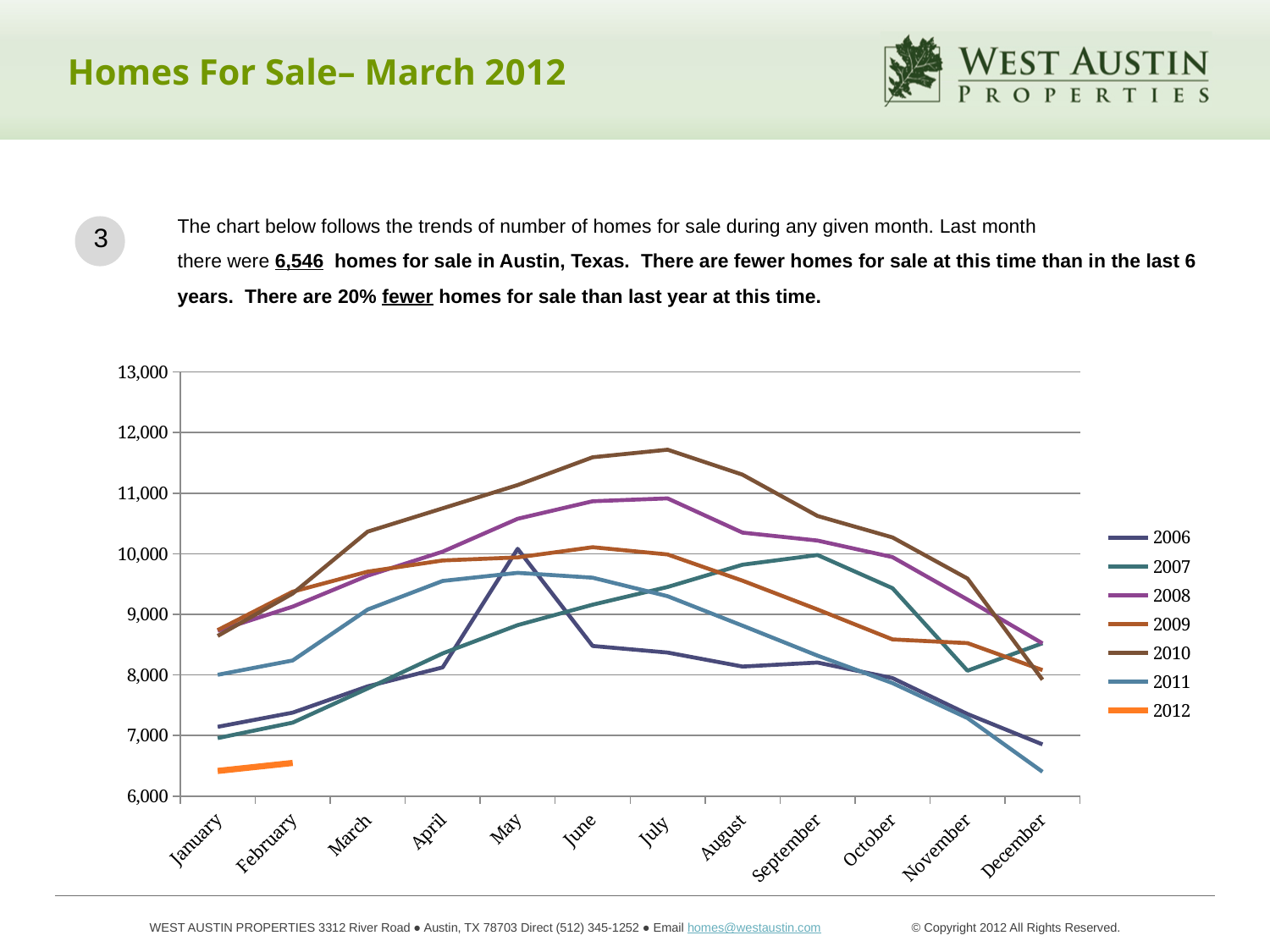
In March, which is larger: the value for 2011 or the value for 2007? 2011 Which year's line has the lowest value in January? 2012 Is the value for 2008 in July greater or less than 10,000? greater Is the value for 2012 in January greater or less than 7,000? less Which year's line reaches the highest point on the chart? 2010 Is the value for 2010 in July greater or less than 11,000? greater How many series does the legend list? 7 What kind of chart is shown on the slide? line chart How many months are shown along the x axis? 12 Which year's line has the lowest value in December? 2011 Does the 2010 line rise or fall from January to July? rise What colour is the 2012 line in the legend? orange